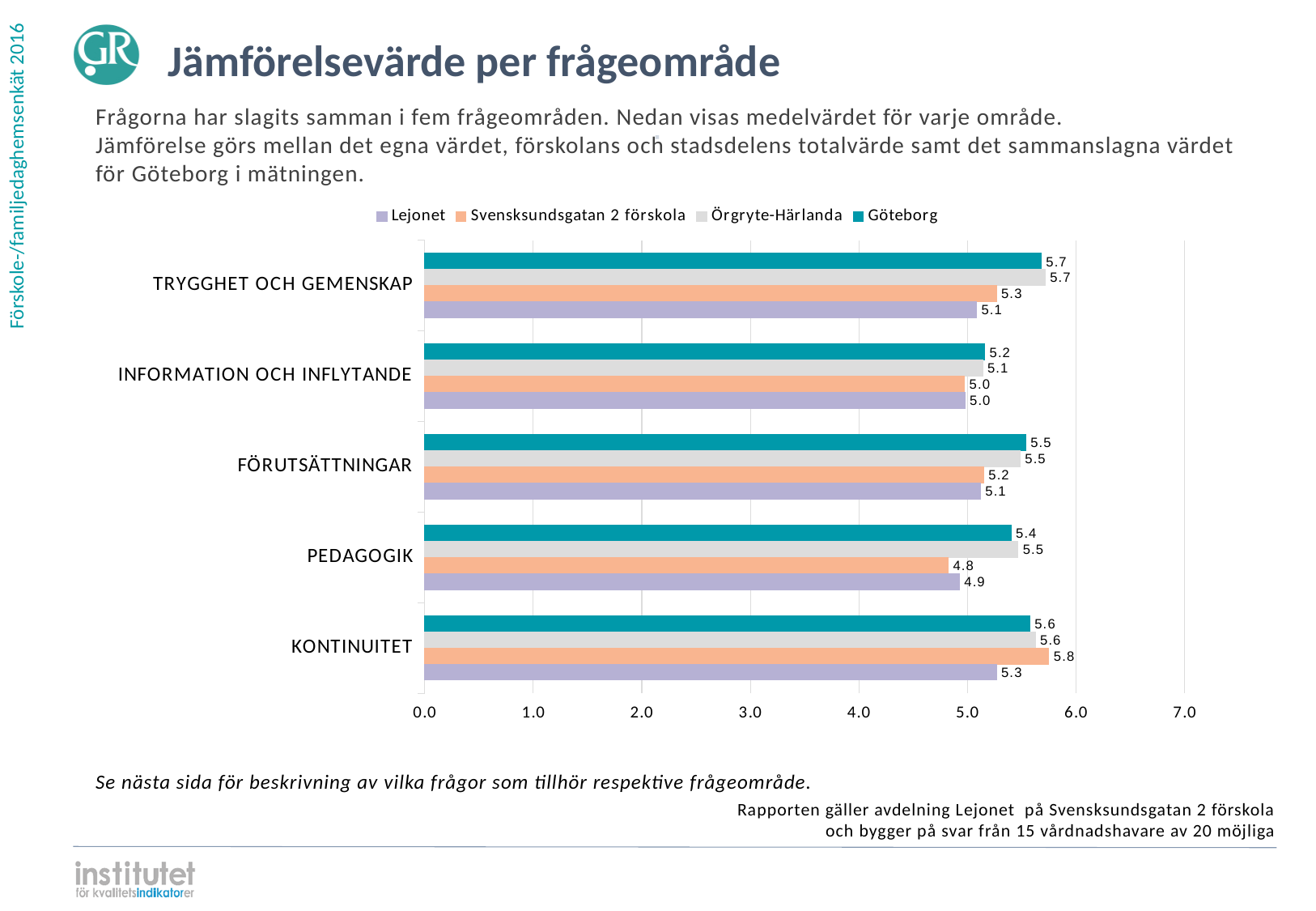
What is the value for Lejonet in the TRYGGHET OCH GEMENSKAP category? 5.1 How many series does the legend list? 4 What kind of chart is shown on the slide? Bar chart What is the value for Örgryte-Härlanda in the INFORMATION OCH INFLYTANDE category? 5.1 In the KONTINUITET category, which is larger: the value for Svensksundsgatan 2 förskola or the value for Göteborg? Svensksundsgatan 2 förskola What is the value for Svensksundsgatan 2 förskola in the KONTINUITET category? 5.8 What is the value for Göteborg in the PEDAGOGIK category? 5.4 What is the title of the slide? Jämförelsevärde per frågeområde What is the difference between the Göteborg value and the Lejonet value in the TRYGGHET OCH GEMENSKAP category? 0.6 How many categories are shown on the chart? 5 In which category does Lejonet have its highest value? KONTINUITET In which category does Svensksundsgatan 2 förskola have its lowest value? PEDAGOGIK